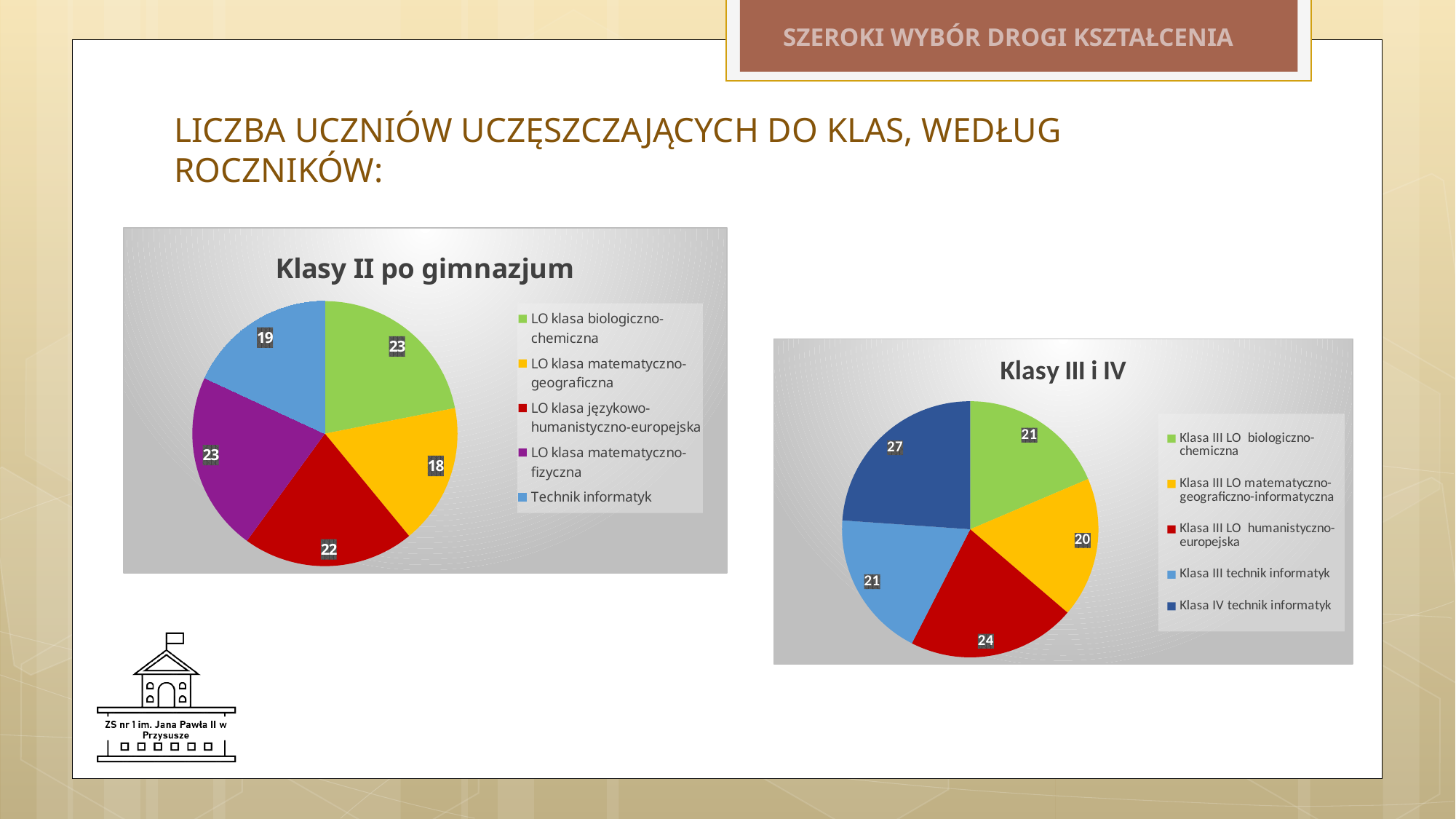
In the 'Klasy III i IV' chart, what is the value for Klasa III LO humanistyczno-europejska? 24 In the 'Klasy II po gimnazjum' chart, which category has the lowest value? LO klasa matematyczno-geograficzna What type of chart is 'Klasy II po gimnazjum'? pie chart In the 'Klasy II po gimnazjum' chart, what is the value for LO klasa matematyczno-geograficzna? 18 In the 'Klasy II po gimnazjum' chart, how many categories does the legend list? 5 In the 'Klasy III i IV' chart, what colour is the slice for Klasa IV technik informatyk? dark blue In the 'Klasy III i IV' chart, what is the value for Klasa IV technik informatyk? 27 In the 'Klasy II po gimnazjum' chart, what is the value for Technik informatyk? 19 In the 'Klasy II po gimnazjum' chart, what is the difference between LO klasa językowo-humanistyczno-europejska and LO klasa matematyczno-geograficzna? 4 In the 'Klasy III i IV' chart, which is larger: Klasa III LO humanistyczno-europejska or Klasa III technik informatyk? Klasa III LO humanistyczno-europejska In the 'Klasy III i IV' chart, which category has the highest value? Klasa IV technik informatyk In the 'Klasy III i IV' chart, which category has the lowest value? Klasa III LO matematyczno-geograficzno-informatyczna